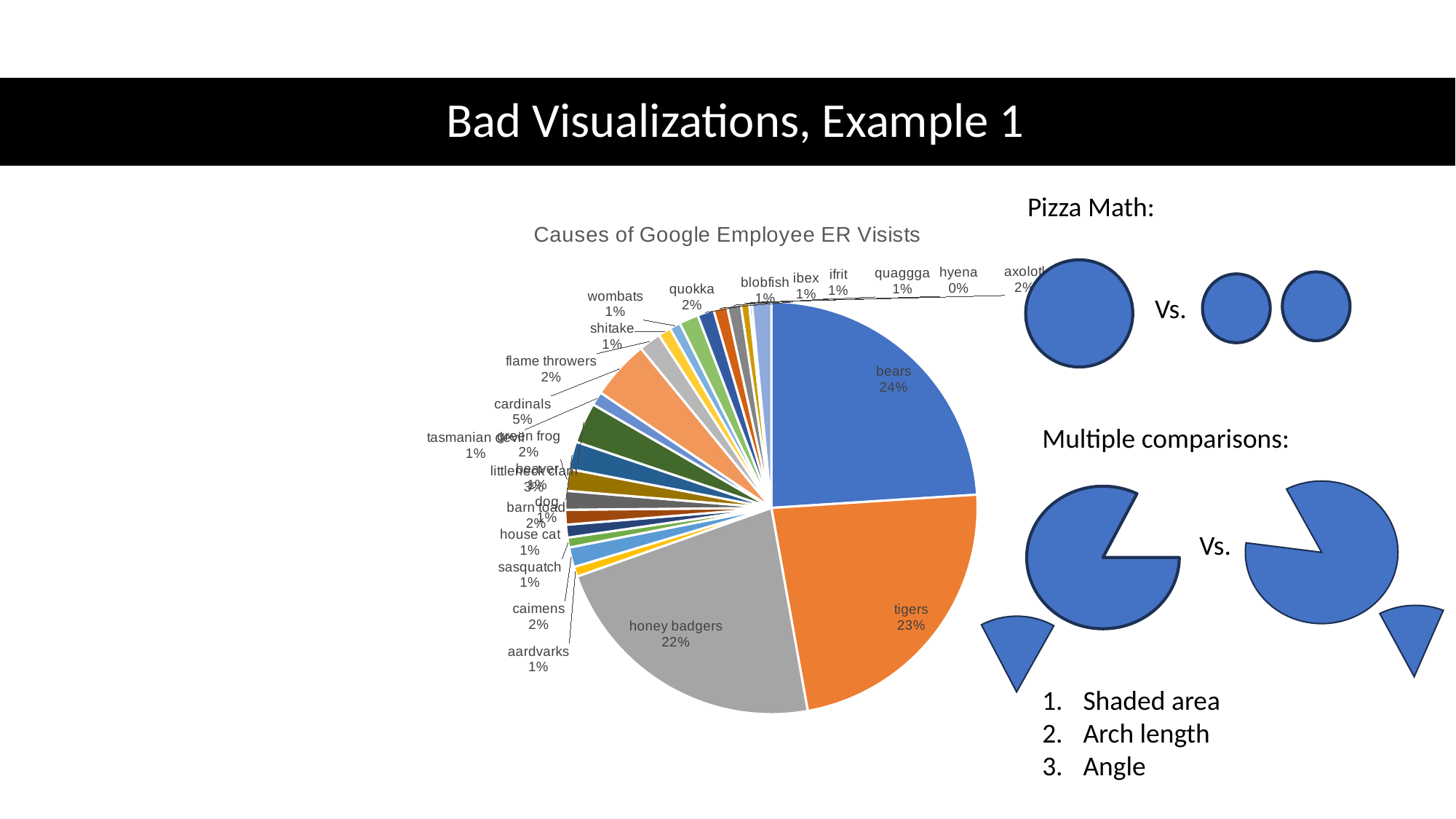
Which category has the smallest labelled share of the pie? hyena Which has the larger share, tigers or honey badgers? tigers What is the difference in percentage points between bears and honey badgers? 2% Which category has the largest slice of the pie? bears What percentage is shown for tigers? 23% What percentage is shown for honey badgers? 22% What percentage is shown for cardinals? 5% What share of the pie is labelled for bears? 24% What type of chart is shown under the title "Causes of Google Employee ER Visists"? pie chart What percentage is shown for hyena? 0% What is the title of the pie chart? Causes of Google Employee ER Visists What is the difference in percentage points between cardinals and quokka? 3%